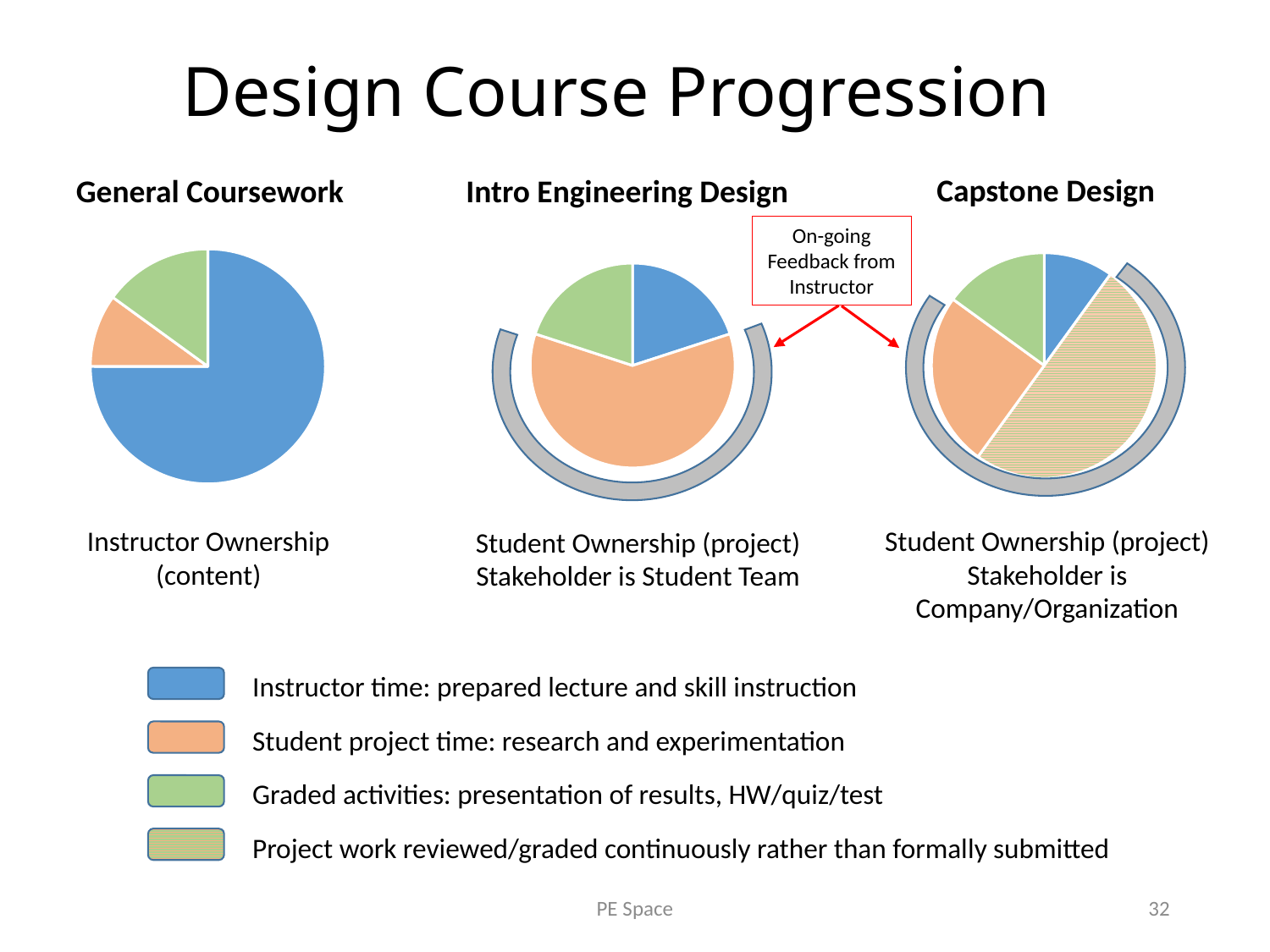
In the Capstone Design pie chart, which is larger: the Student project time slice or the Instructor time slice? Student project time In the General Coursework pie chart, which category has the largest slice? Instructor time: prepared lecture and skill instruction How many entries does the legend at the bottom of the slide list? 4 What kind of chart is used for General Coursework? pie chart In the General Coursework pie chart, which is larger: the Instructor time slice or the Graded activities slice? Instructor time In the Intro Engineering Design pie chart, which category has the largest slice? Student project time: research and experimentation How many pie charts are shown on the slide? 3 What is the title of the pie chart on the right of the slide? Capstone Design In the Capstone Design pie chart, which category has the largest slice? Project work reviewed/graded continuously rather than formally submitted Which legend entry is shown with a striped pattern? Project work reviewed/graded continuously rather than formally submitted How many slices does the Capstone Design pie chart have? 4 How many slices does the General Coursework pie chart have? 3